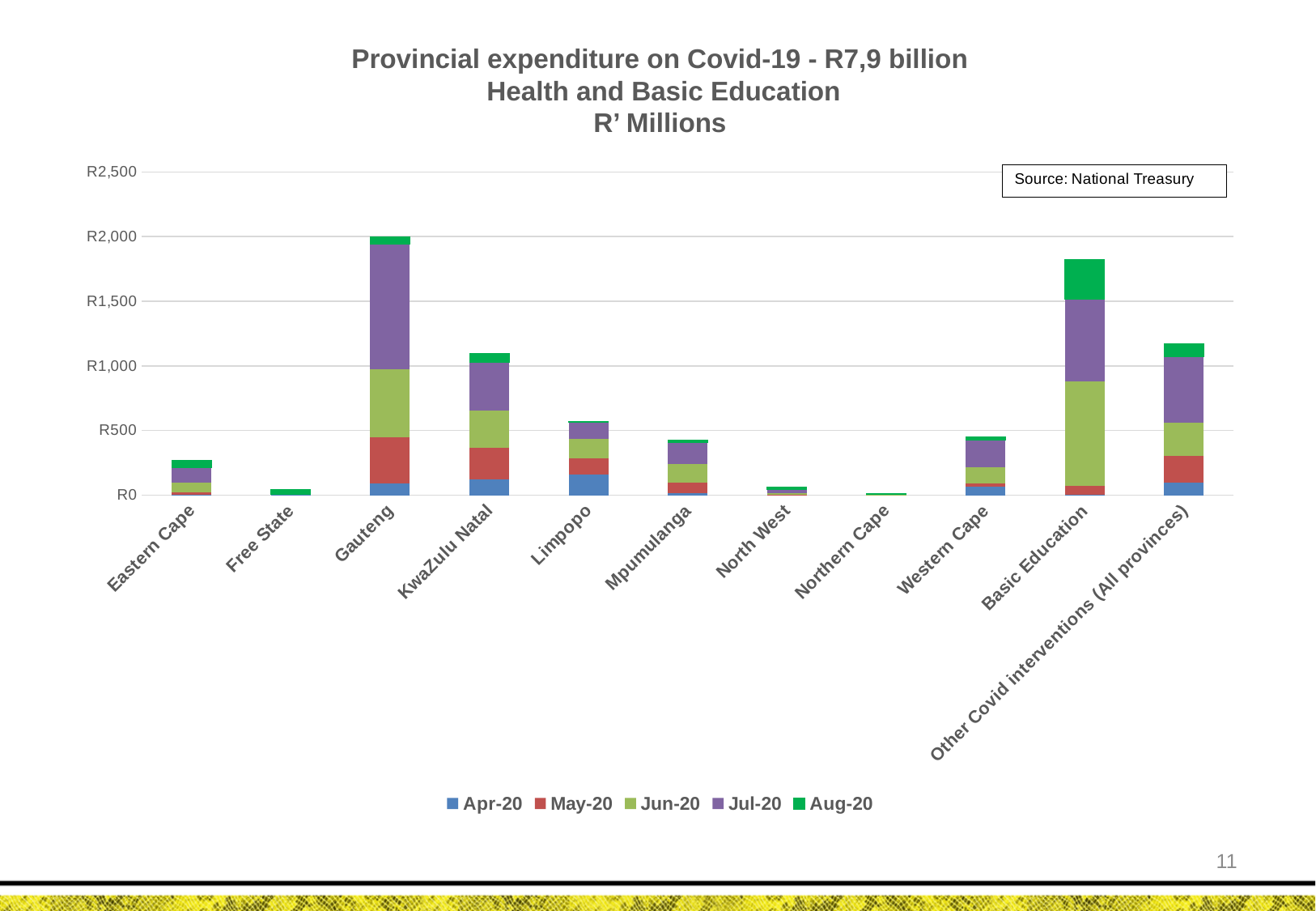
Which category has the highest total expenditure? Gauteng What source is cited for the chart data? National Treasury Is the total value for KwaZulu Natal greater or less than R1,000? greater Is the total value for Gauteng greater or less than R1,500? greater Which category has the lowest total expenditure? Northern Cape How many categories are shown along the x axis? 11 Which has the larger total expenditure, KwaZulu Natal or Limpopo? KwaZulu Natal How many series does the legend list? 5 Is the total value for Mpumulanga greater or less than R500? less What kind of chart is shown on the slide? Stacked bar chart Which has the larger total expenditure, Basic Education or Other Covid interventions (All provinces)? Basic Education